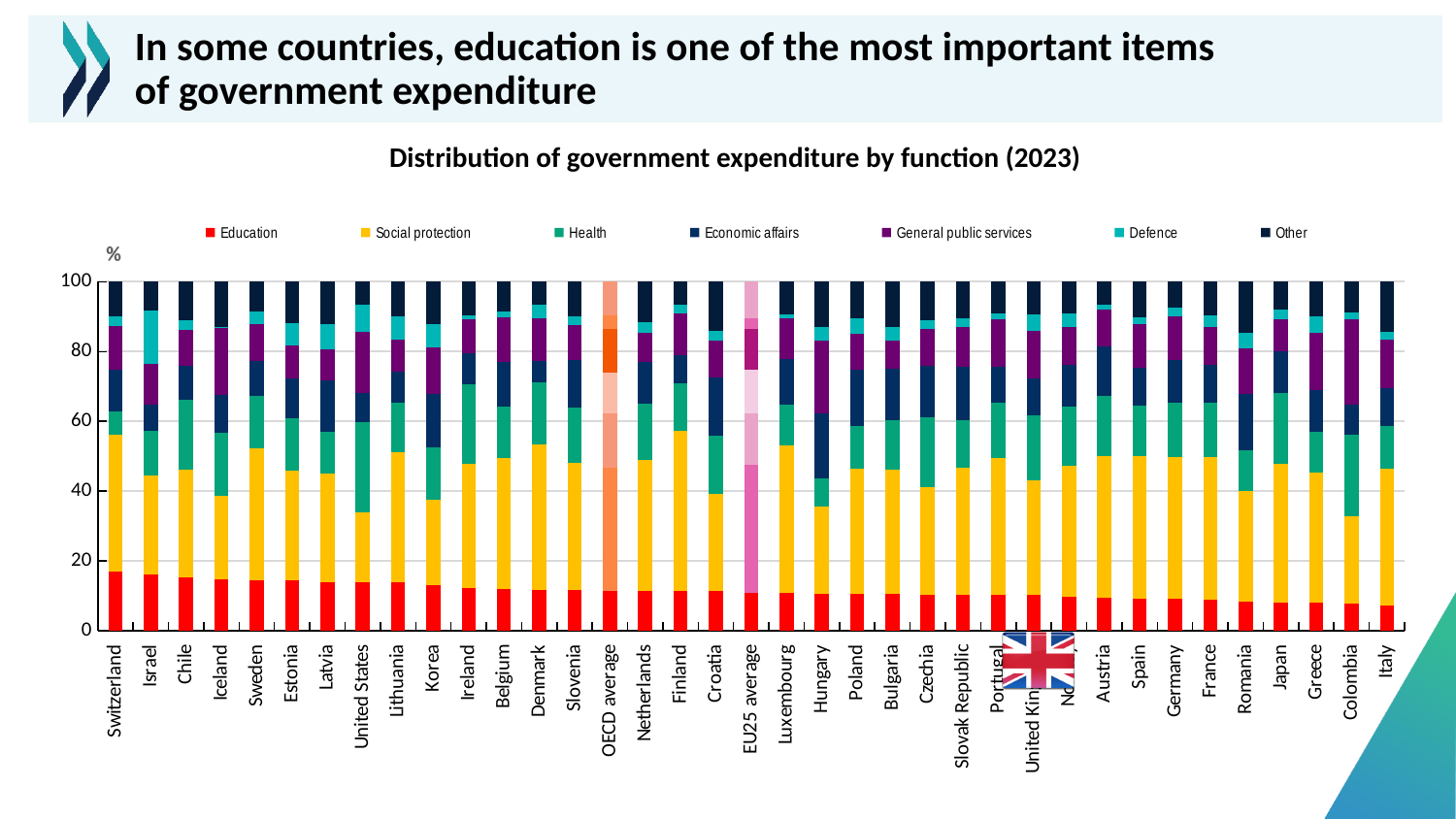
Is the Education segment for Switzerland greater or less than 10? greater What kind of chart is shown on the slide? Stacked bar chart Is the Education segment for Switzerland greater or less than 20? less What is the title of the chart? Distribution of government expenditure by function (2023) Which has a larger Social protection segment, Switzerland or Colombia? Switzerland How many series does the legend list? 7 Which has a larger Education share, Switzerland or Italy? Switzerland What is the unit shown on the y axis? % Which country has the largest Education share of government expenditure? Switzerland What colour represents Education in the chart? Red Is the Education segment for Italy greater or less than 10? less Does the Education share rise or fall moving from left to right along the x axis? fall